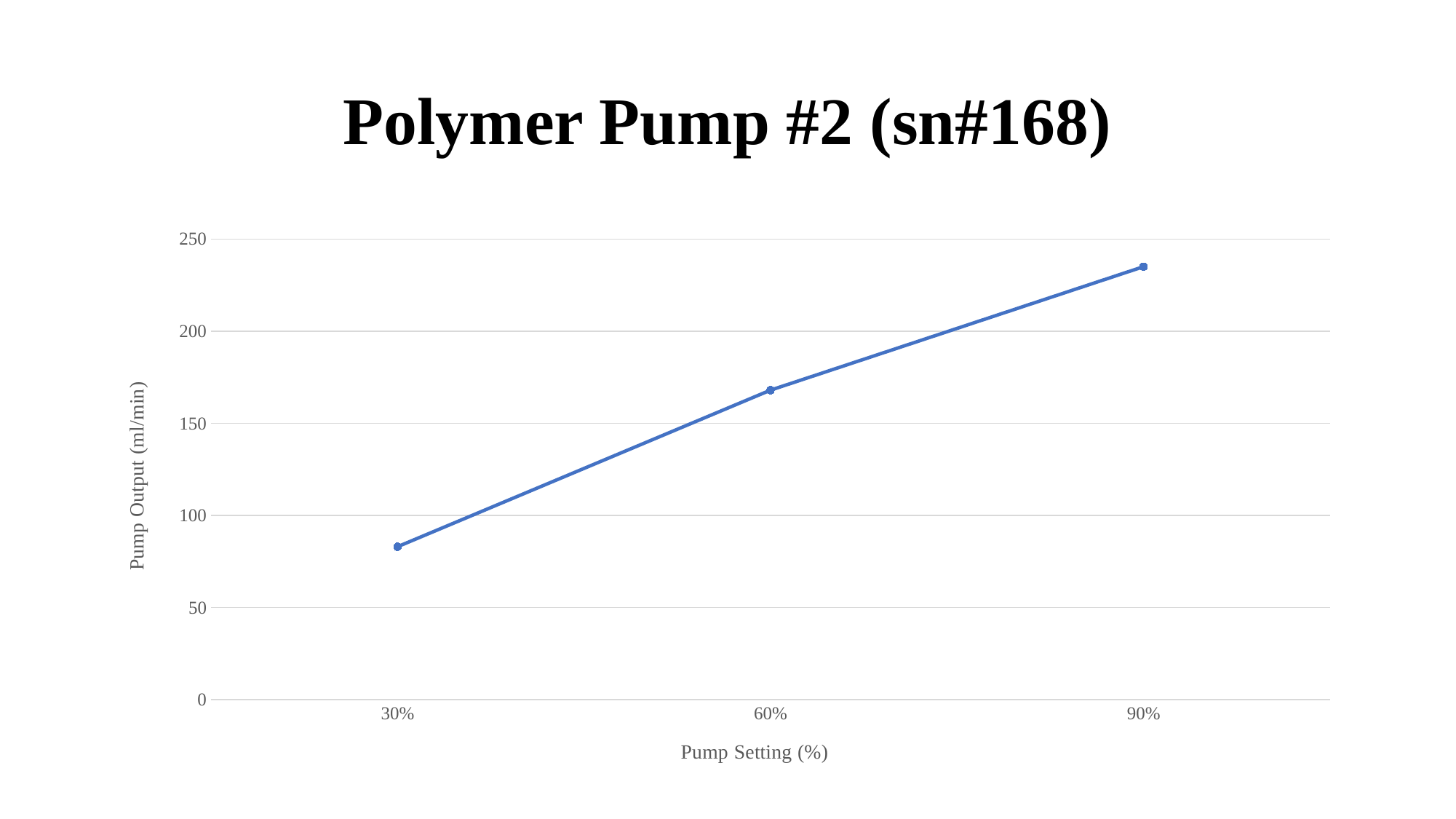
Is the pump output at the 90% setting greater or less than 200? greater What is the title of the chart? Polymer Pump #2 (sn#168) What is the label of the y axis? Pump Output (ml/min) Is the pump output at the 90% setting greater or less than 250? less How many pump settings are plotted on the x axis? 3 Is the pump output at the 30% setting greater or less than 100? less Which has the larger pump output, the 30% setting or the 60% setting? 60% Does the pump output rise or fall as the pump setting increases from 30% to 90%? rise Which pump setting has the highest pump output? 90% What kind of chart is shown on the slide? line chart Which pump setting has the lowest pump output? 30%